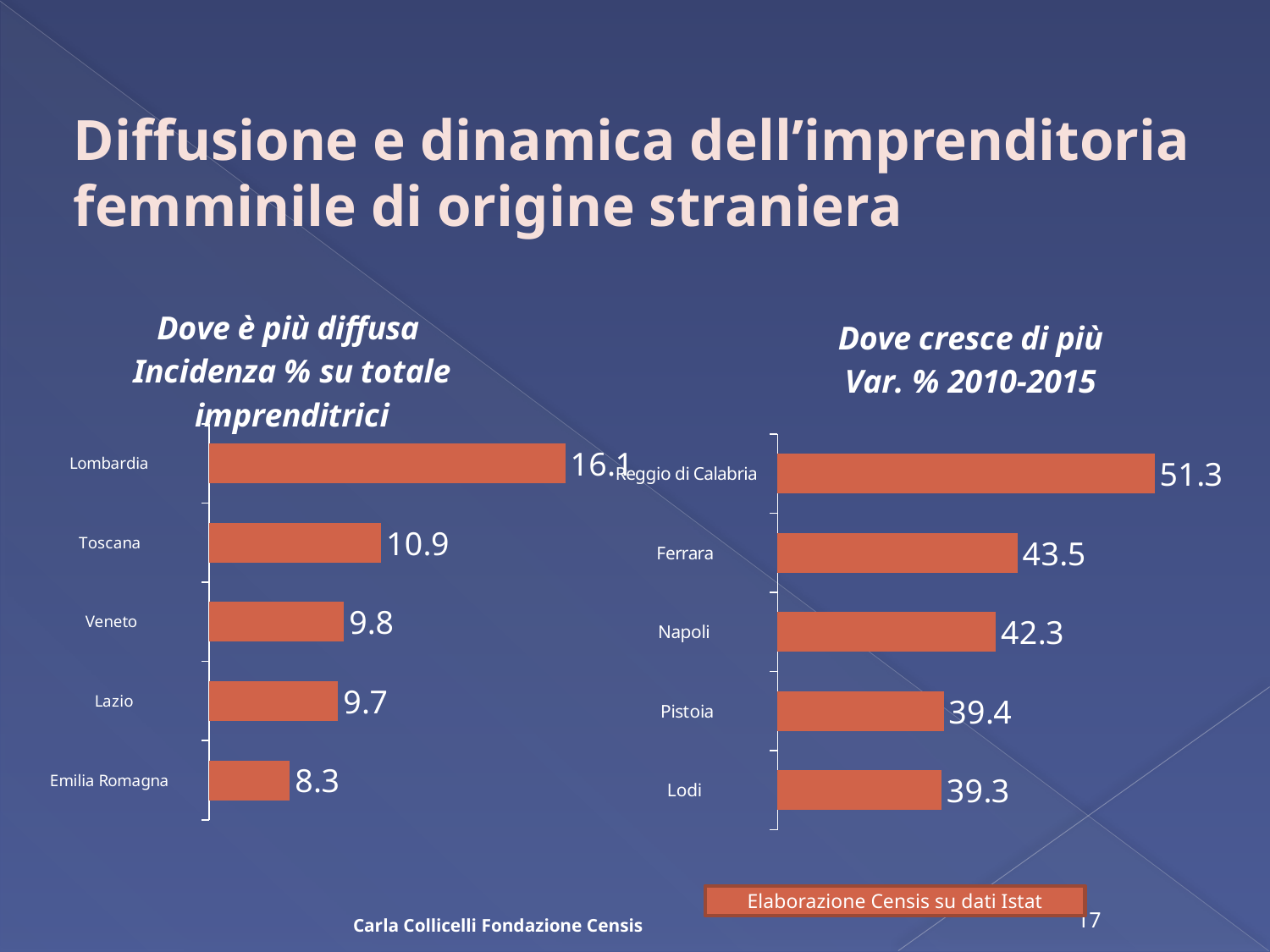
In the right chart (Dove cresce di più), what is the value for Lodi? 39.3 What kind of chart is the right chart (Dove cresce di più)? Bar chart In the right chart (Dove cresce di più), which category has the highest value? Reggio di Calabria In the left chart (Dove è più diffusa), what is the value for Emilia Romagna? 8.3 In the left chart (Dove è più diffusa), what is the value for Lombardia? 16.1 In the left chart (Dove è più diffusa), which category has the lowest value? Emilia Romagna In the right chart (Dove cresce di più), what is the value for Ferrara? 43.5 In the left chart (Dove è più diffusa), what is the difference between the values for Lombardia and Toscana? 5.2 How many categories are shown in the left chart (Dove è più diffusa)? 5 What is the title of the right chart? Dove cresce di più Var. % 2010-2015 In the right chart (Dove cresce di più), which is larger, the value for Ferrara or the value for Pistoia? Ferrara In the right chart (Dove cresce di più), what is the difference between the values for Reggio di Calabria and Napoli? 9.0